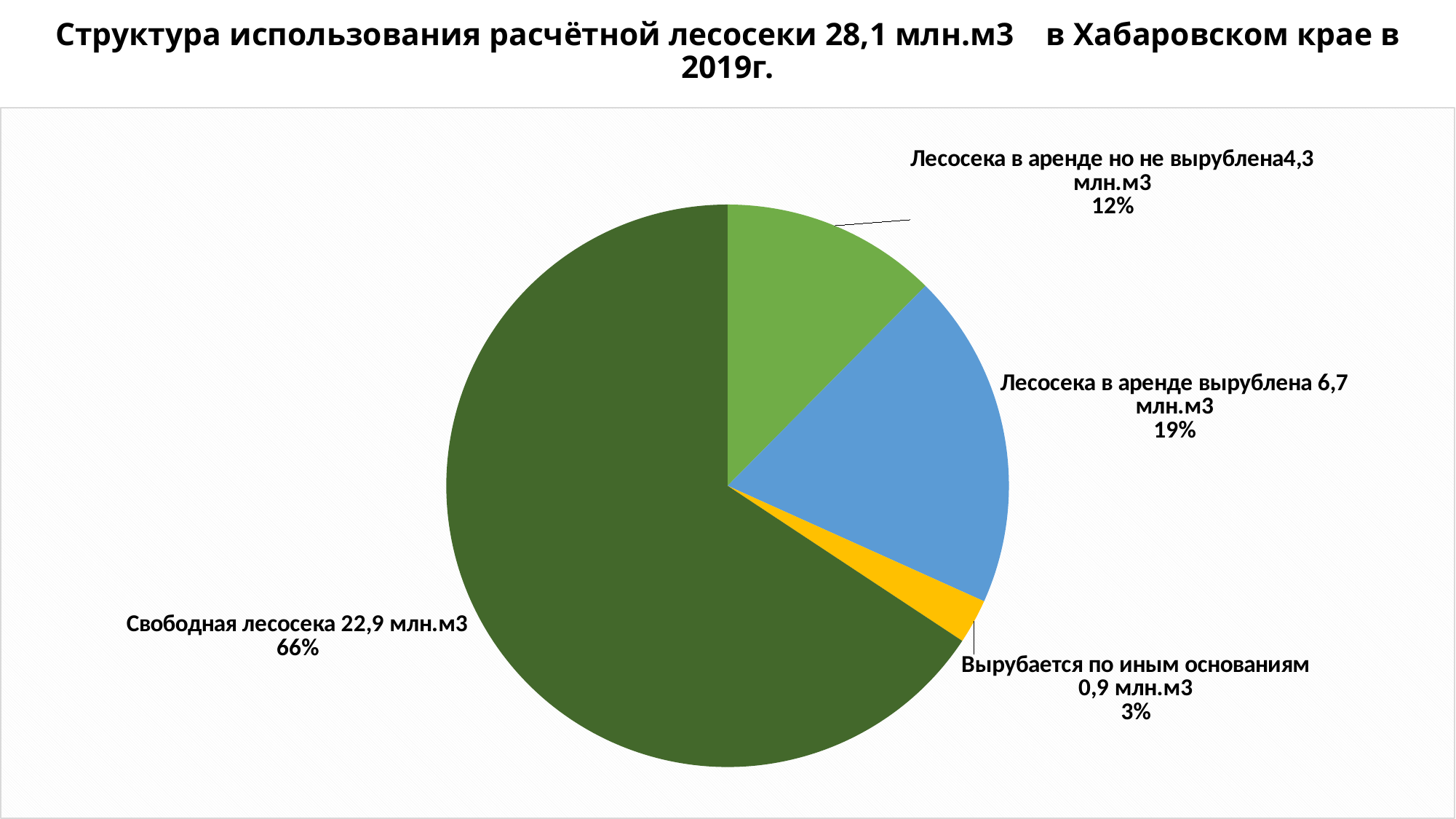
What share of the pie does "Вырубается по иным основаниям" take? 3% How many slices does the pie chart have? 4 Which is larger: the slice for "Лесосека в аренде вырублена" or the slice for "Лесосека в аренде но не вырублена"? Лесосека в аренде вырублена What share of the pie does "Лесосека в аренде вырублена" take? 19% What share of the pie does "Свободная лесосека" take? 66% What is the volume for "Лесосека в аренде вырублена"? 6,7 млн.м3 What is the volume for "Свободная лесосека"? 22,9 млн.м3 Which category has the smallest slice? Вырубается по иным основаниям What is the difference in volume between "Лесосека в аренде вырублена" and "Лесосека в аренде но не вырублена"? 2,4 млн.м3 What kind of chart is shown on the slide? pie chart Which category has the largest slice? Свободная лесосека